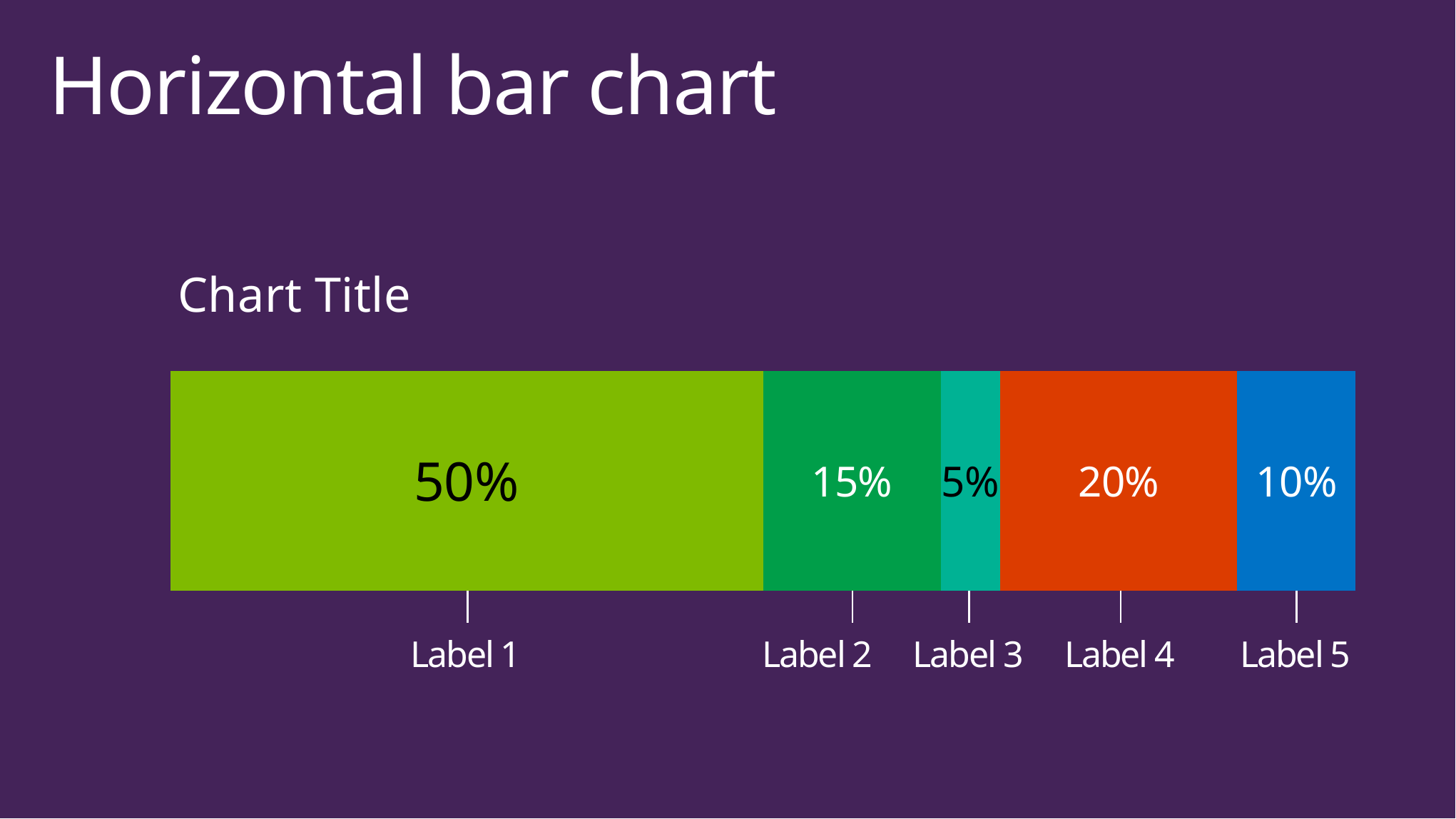
What is the value for Label 3? 5% Which segment has the highest value? Label 1 What is the difference between the values for Label 1 and Label 4? 30% What is the value for Label 5? 10% What is the value for Label 1? 50% How many segments are in the bar? 5 What kind of chart is shown on the slide? Bar chart Which is larger, the value for Label 2 or the value for Label 5? Label 2 Which segment has the lowest value? Label 3 What is the value for Label 2? 15% What is the total of all the segments in the bar? 100% What is the value for Label 4? 20%